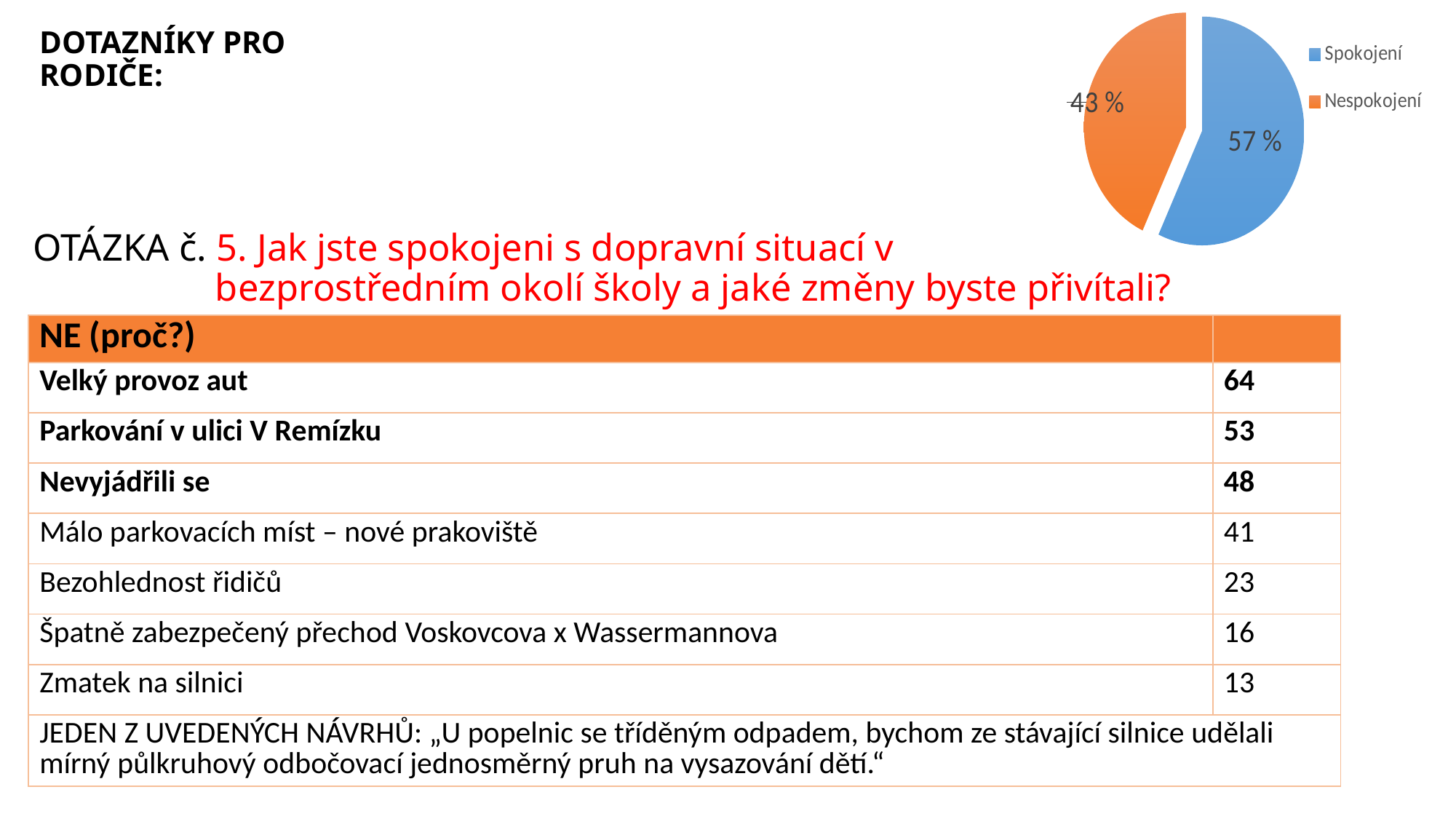
What share of the pie chart is labelled Spokojení? 57 % Which slice of the pie chart is the largest? Spokojení Is the share for Spokojení greater or less than 50 %? greater How many slices does the pie chart have? 2 How many entries does the legend of the pie chart list? 2 What is the difference in percentage points between the Spokojení and Nespokojení slices? 14 What colour is the Spokojení slice in the pie chart? blue What kind of chart is shown on the slide? pie chart What colour is the Nespokojení slice in the pie chart? orange Which is larger in the pie chart, Spokojení or Nespokojení? Spokojení Which slice of the pie chart is the smallest? Nespokojení What share of the pie chart is labelled Nespokojení? 43 %